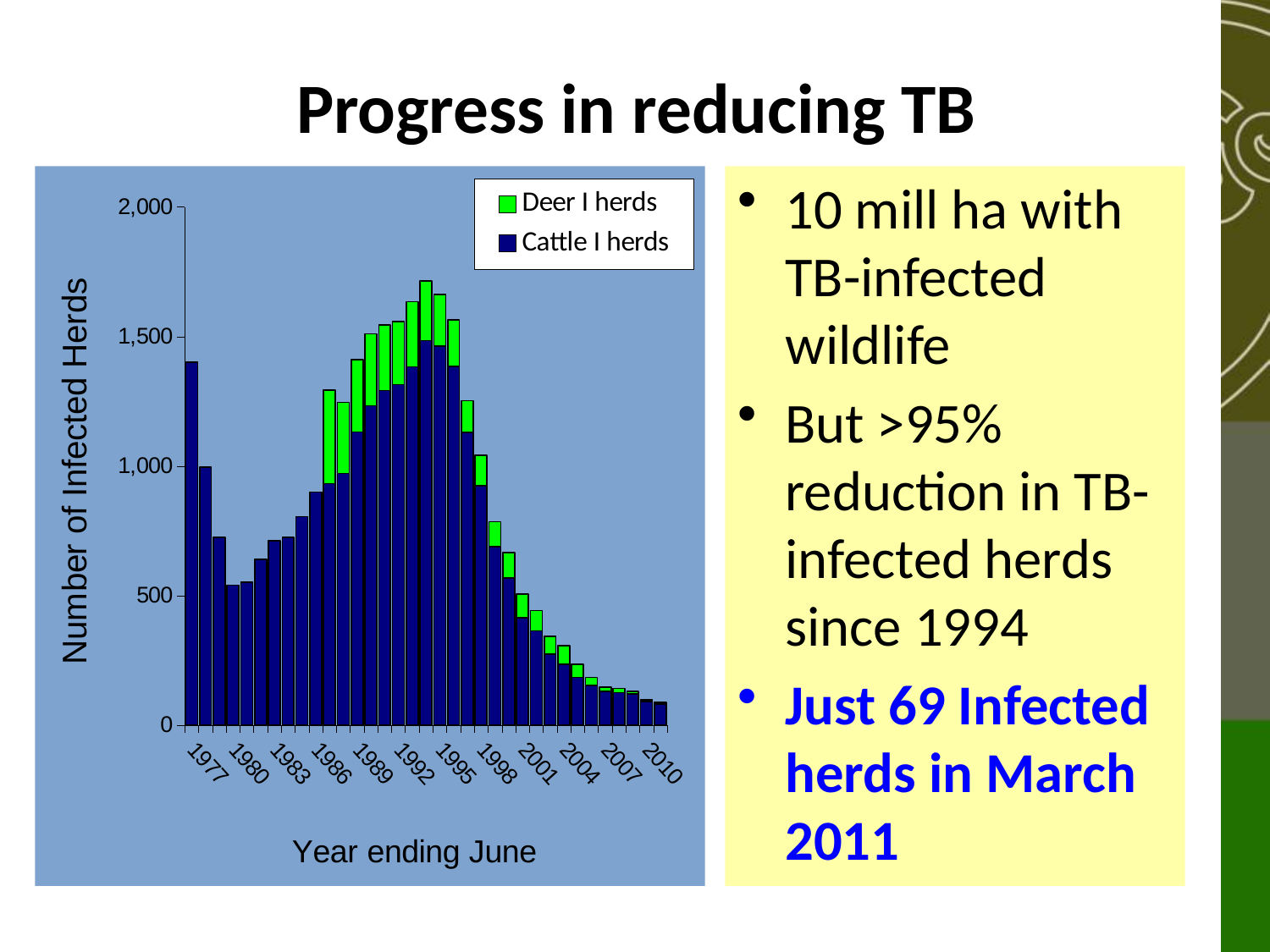
What kind of chart is shown on the slide? stacked bar chart Do the total infected herd numbers rise or fall from 1992 to 2010? fall Which is larger, the total number of infected herds in 1992 or in 2007? 1992 What are the two series named in the chart legend? Deer I herds and Cattle I herds What is the label on the chart's vertical axis? Number of Infected Herds Is the total number of infected herds in 2004 greater or less than 500? less Is the total number of infected herds in 2010 greater or less than 500? less Is the value for Cattle I herds in 1977 greater or less than 1,000? greater How many series does the chart legend list? 2 Which year has the highest total number of infected herds? 1994